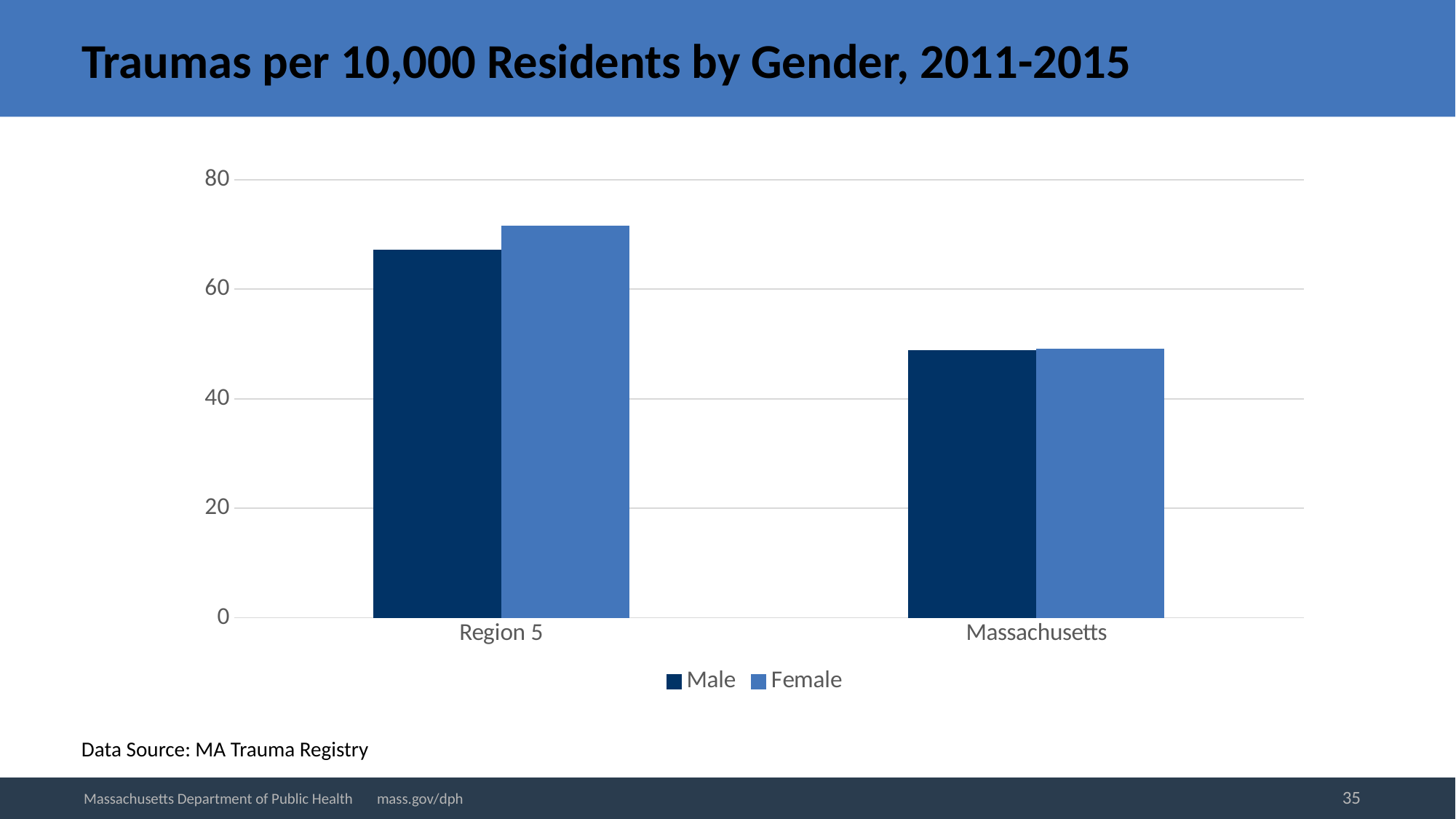
How many series does the legend list? 2 How many categories are shown on the x axis? 2 What is the data source listed on the slide? MA Trauma Registry Is the Male value for Region 5 greater or less than 60? greater Which category has the lowest Female value? Massachusetts Is the Female value for Region 5 greater or less than 80? less Is the Male value for Massachusetts greater or less than 60? less What kind of chart is shown on the slide? bar chart What is the title of the chart? Traumas per 10,000 Residents by Gender, 2011-2015 Which category has the higher Male value, Region 5 or Massachusetts? Region 5 For Region 5, which is larger, the Male value or the Female value? Female